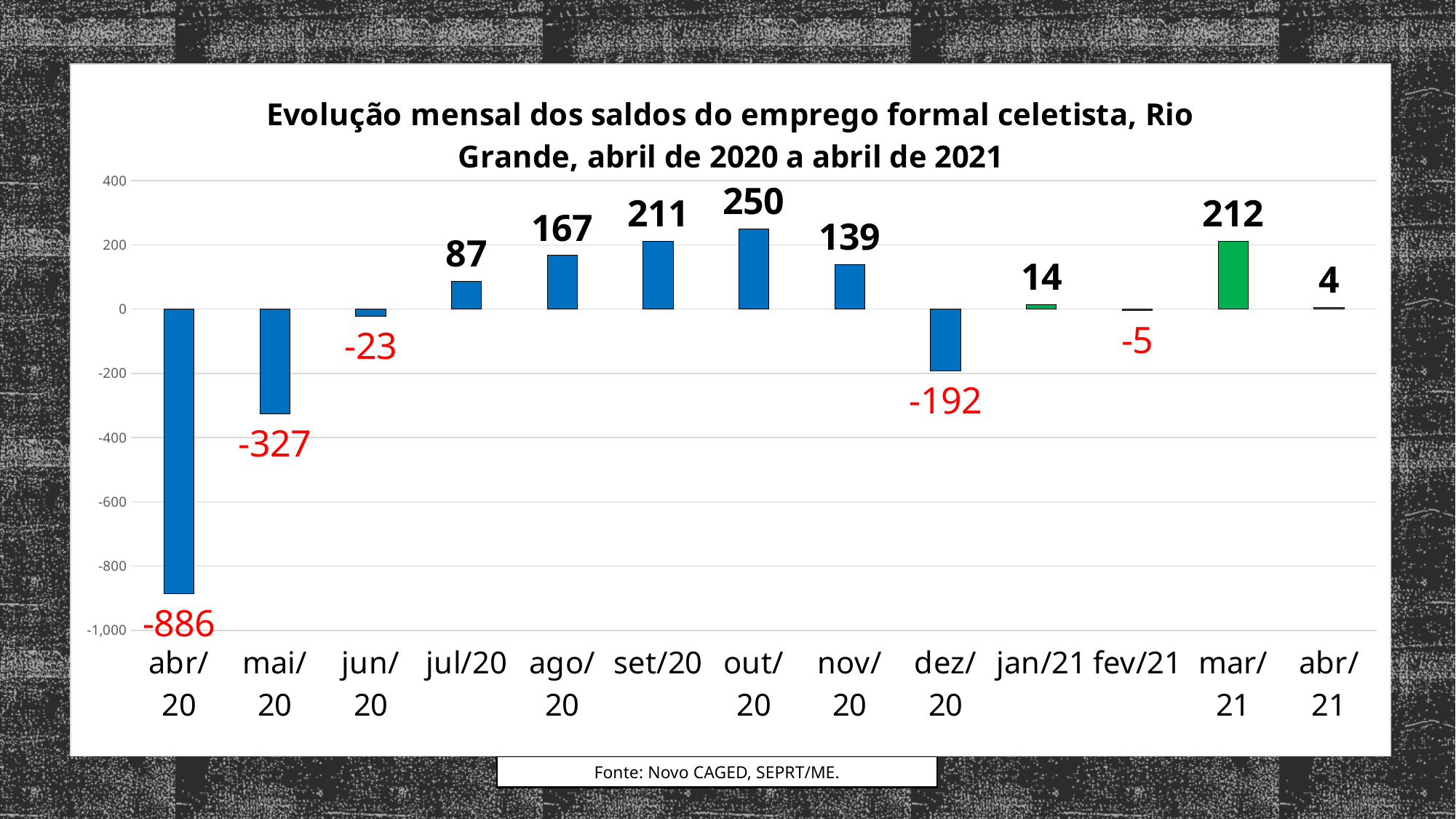
What is the value for out/20? 250 Which month has the highest value? out/20 What is the source cited below the chart? Novo CAGED, SEPRT/ME. What is the value for dez/20? -192 What is the value for abr/20? -886 How many months are shown on the x axis? 13 What kind of chart is this? bar chart What is the difference between the values for abr/20 and mai/20? 559 Which month has the lowest value? abr/20 What is the value for mar/21? 212 Which is larger, the value for ago/20 or the value for jul/20? ago/20 What is the difference between the values for set/20 and nov/20? 72